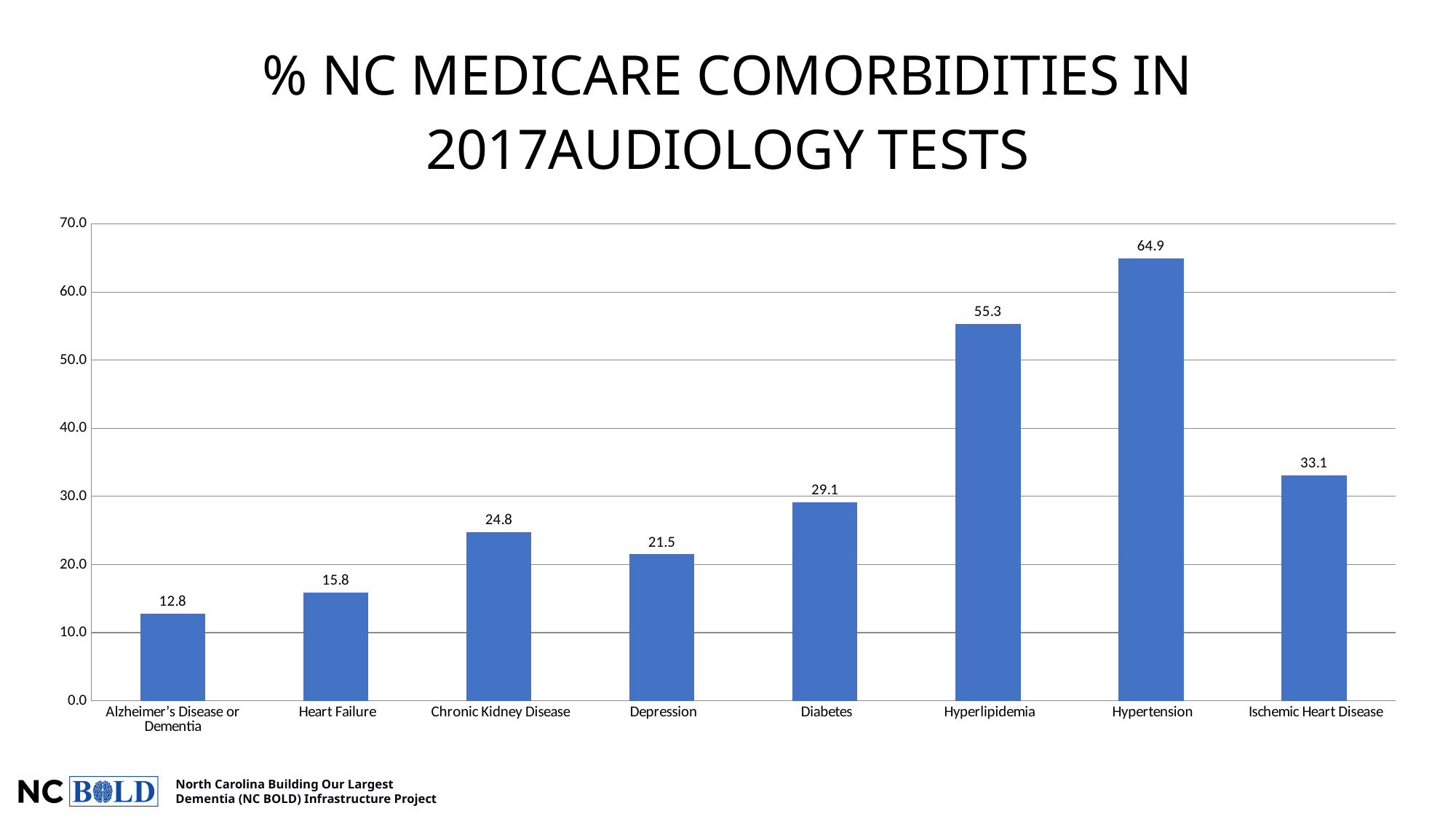
How many categories are shown on the x axis? 8 Which category has the lowest value? Alzheimer's Disease or Dementia Is the value for Hyperlipidemia greater or less than 50.0? greater What is the title of the chart? % NC MEDICARE COMORBIDITIES IN 2017AUDIOLOGY TESTS What is the value for Hypertension? 64.9 What kind of chart is shown on the slide? Bar chart Which category has the highest value? Hypertension Which is larger, the value for Chronic Kidney Disease or the value for Depression? Chronic Kidney Disease What is the value for Alzheimer's Disease or Dementia? 12.8 What is the value for Diabetes? 29.1 What is the difference between the values for Ischemic Heart Disease and Heart Failure? 17.3 What is the difference between the values for Hypertension and Hyperlipidemia? 9.6